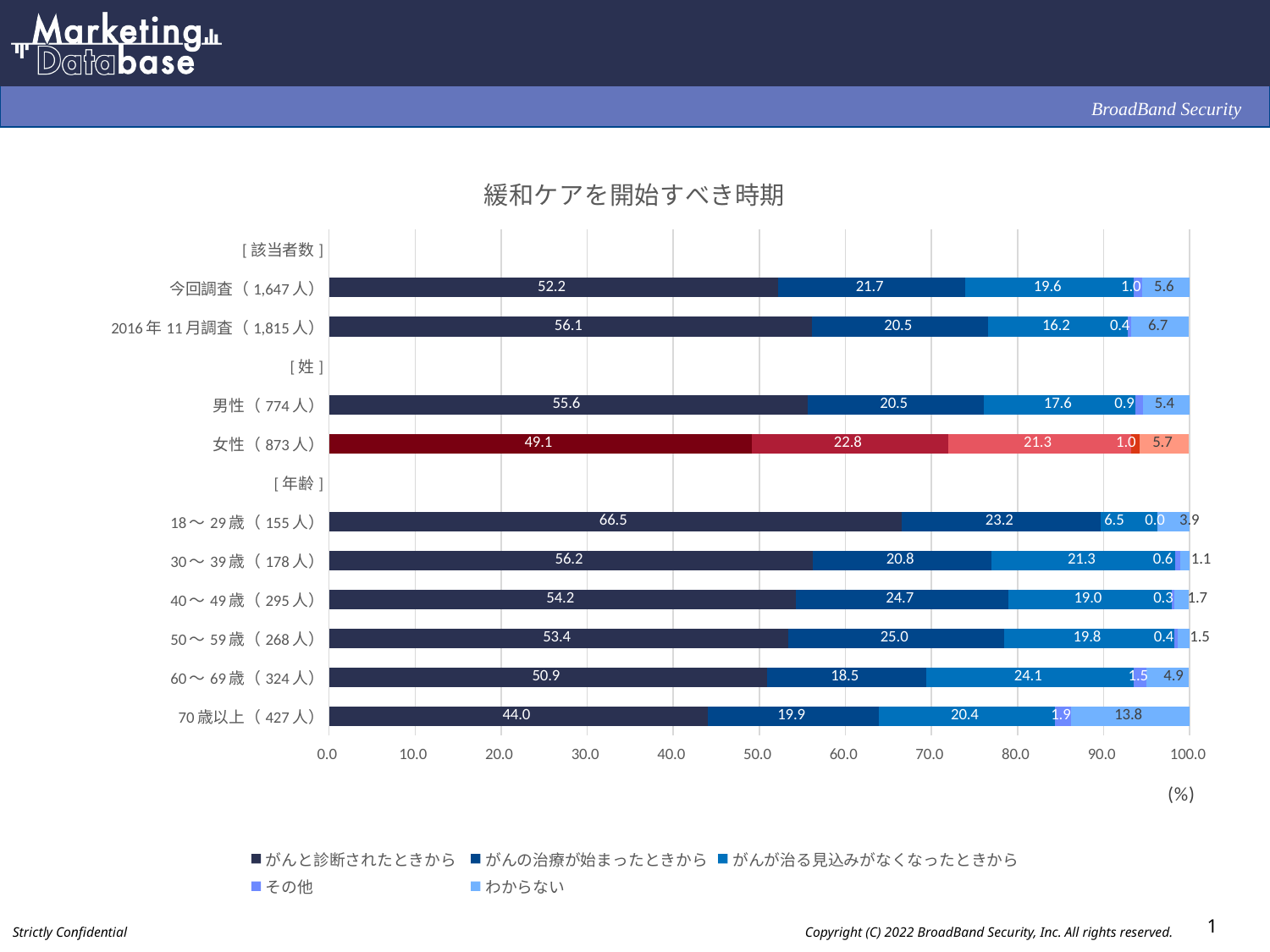
Which age group has the highest value for がんと診断されたときから? 18〜29歳 (155人) What is the title of the chart? 緩和ケアを開始すべき時期 Which category has the lowest value for がんと診断されたときから? 70歳以上 (427人) How many series does the legend list? 5 Which is larger, the がんが治る見込みがなくなったときから value for 60〜69歳 (324人) or for 18〜29歳 (155人)? 60〜69歳 (324人) What is the value of がんの治療が始まったときから for 女性 (873人)? 22.8 What is the value of わからない for 70歳以上 (427人)? 13.8 What type of chart is shown on the slide? Stacked bar chart What is the difference between the わからない values for 2016年11月調査 (1,815人) and 今回調査 (1,647人)? 1.1 What is the value of がんと診断されたときから for 今回調査 (1,647人)? 52.2 What is the difference between the がんと診断されたときから values for 男性 (774人) and 女性 (873人)? 6.5 What is the value of その他 for 18〜29歳 (155人)? 0.0